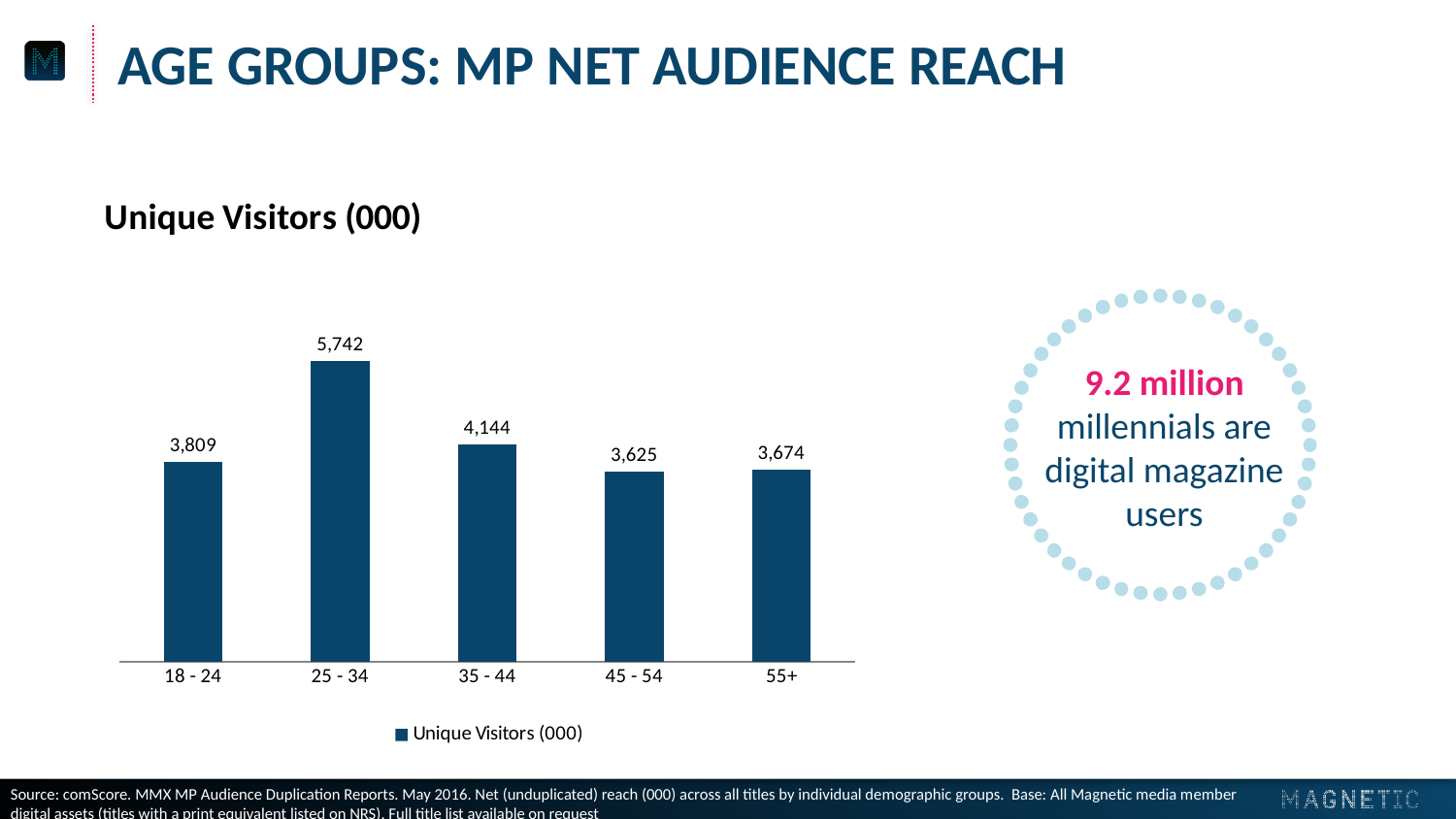
Which age group has more unique visitors, 18 - 24 or 35 - 44? 35 - 44 What kind of chart is shown on the slide? Bar chart What is the value of Unique Visitors (000) for the 25 - 34 age group? 5,742 How many series does the legend list? 1 What is the title of the chart? Unique Visitors (000) What is the value of Unique Visitors (000) for the 55+ age group? 3,674 Which age group has the highest number of unique visitors? 25 - 34 How many age groups are shown in the chart? 5 Which age group has the lowest number of unique visitors? 45 - 54 What is the difference in Unique Visitors (000) between the 25 - 34 and 35 - 44 age groups? 1,598 What is the difference in Unique Visitors (000) between the 18 - 24 and 45 - 54 age groups? 184 What is the value of Unique Visitors (000) for the 45 - 54 age group? 3,625